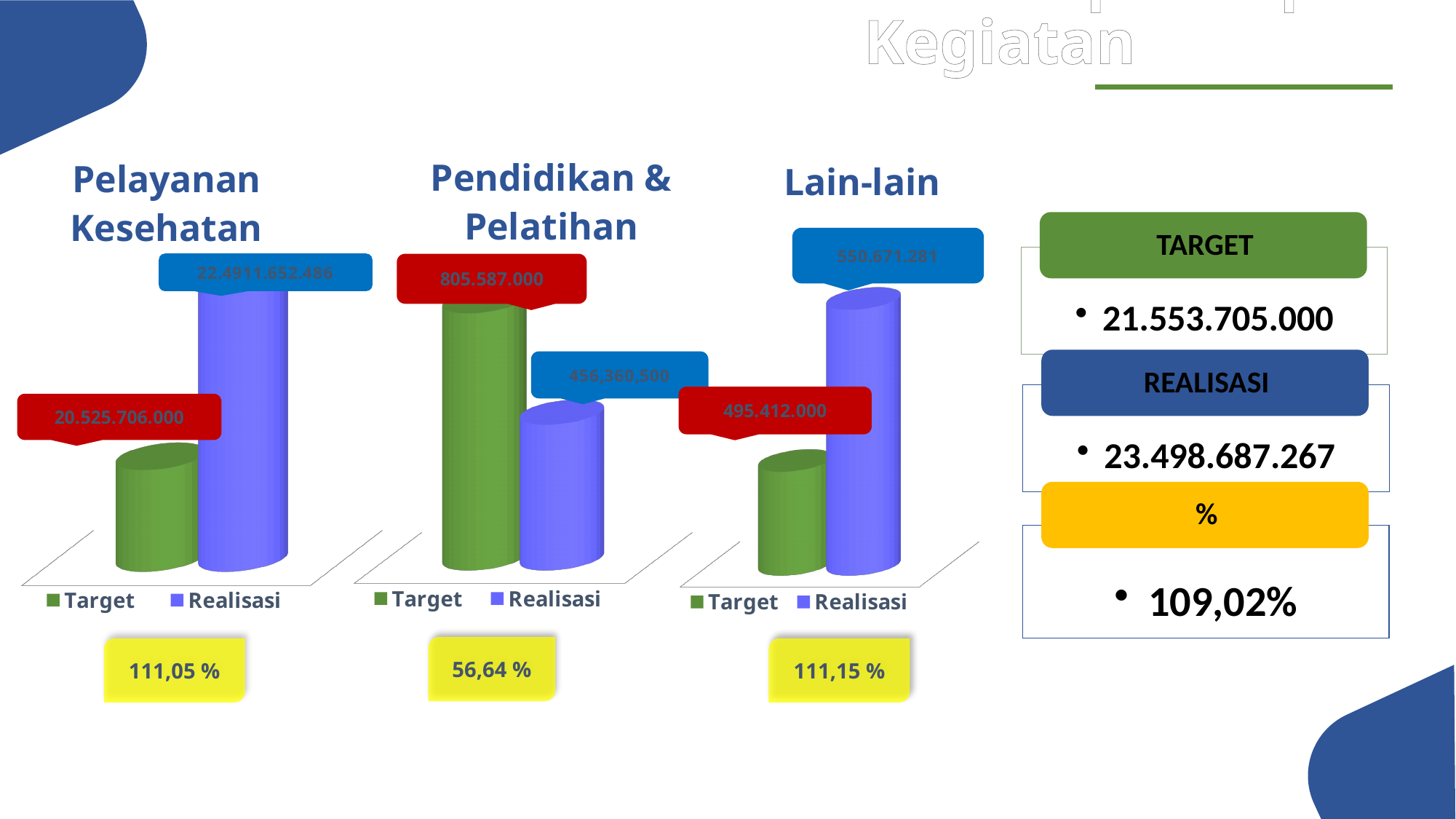
In the Pendidikan & Pelatihan chart, which bar is taller, Target or Realisasi? Target In the Lain-lain chart, what is the difference between the Realisasi value and the Target value? 55.259.281 In the Lain-lain chart, what is the value of the Target bar? 495.412.000 In the Pendidikan & Pelatihan chart, what is the value of the Realisasi bar? 456,360,500 In the Lain-lain chart, what is the value of the Realisasi bar? 550.671.281 What kind of chart is used for Pelayanan Kesehatan? Bar chart What colour is the Target series in the Lain-lain chart? Green How many series does the legend of the Pendidikan & Pelatihan chart list? 2 In the Pelayanan Kesehatan chart, which bar is taller, Target or Realisasi? Realisasi In the Pendidikan & Pelatihan chart, what is the value of the Target bar? 805.587.000 In the Pelayanan Kesehatan chart, what is the value of the Target bar? 20.525.706.000 In the Lain-lain chart, which bar is taller, Target or Realisasi? Realisasi